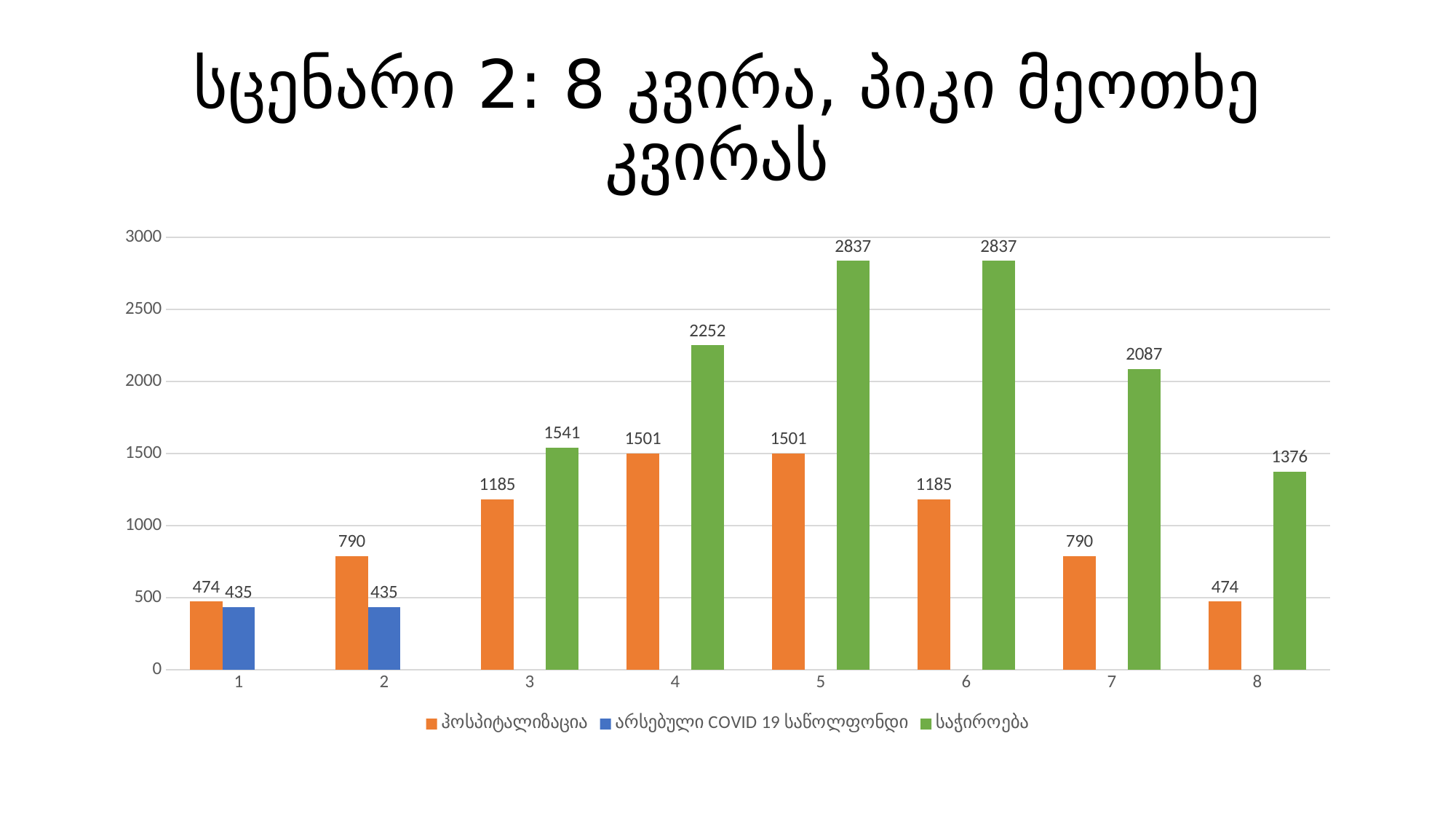
What is the value of საჭიროება for category 7? 2087 Which category has the lowest value for საჭიროება? 8 How many categories are shown on the x axis? 8 Which category has the highest value for ჰოსპიტალიზაცია? 4 and 5 Which is larger for category 1: ჰოსპიტალიზაცია or არსებული COVID 19 საწოლფონდი? ჰოსპიტალიზაცია What is the difference between საჭიროება and ჰოსპიტალიზაცია for category 5? 1336 Does the value of ჰოსპიტალიზაცია rise or fall from category 5 to category 8? fall What is the value of არსებული COVID 19 საწოლფონდი for category 2? 435 What is the value of ჰოსპიტალიზაცია for category 4? 1501 How many series does the legend list? 3 What kind of chart is shown on the slide? bar chart What colour are the bars for საჭიროება? green